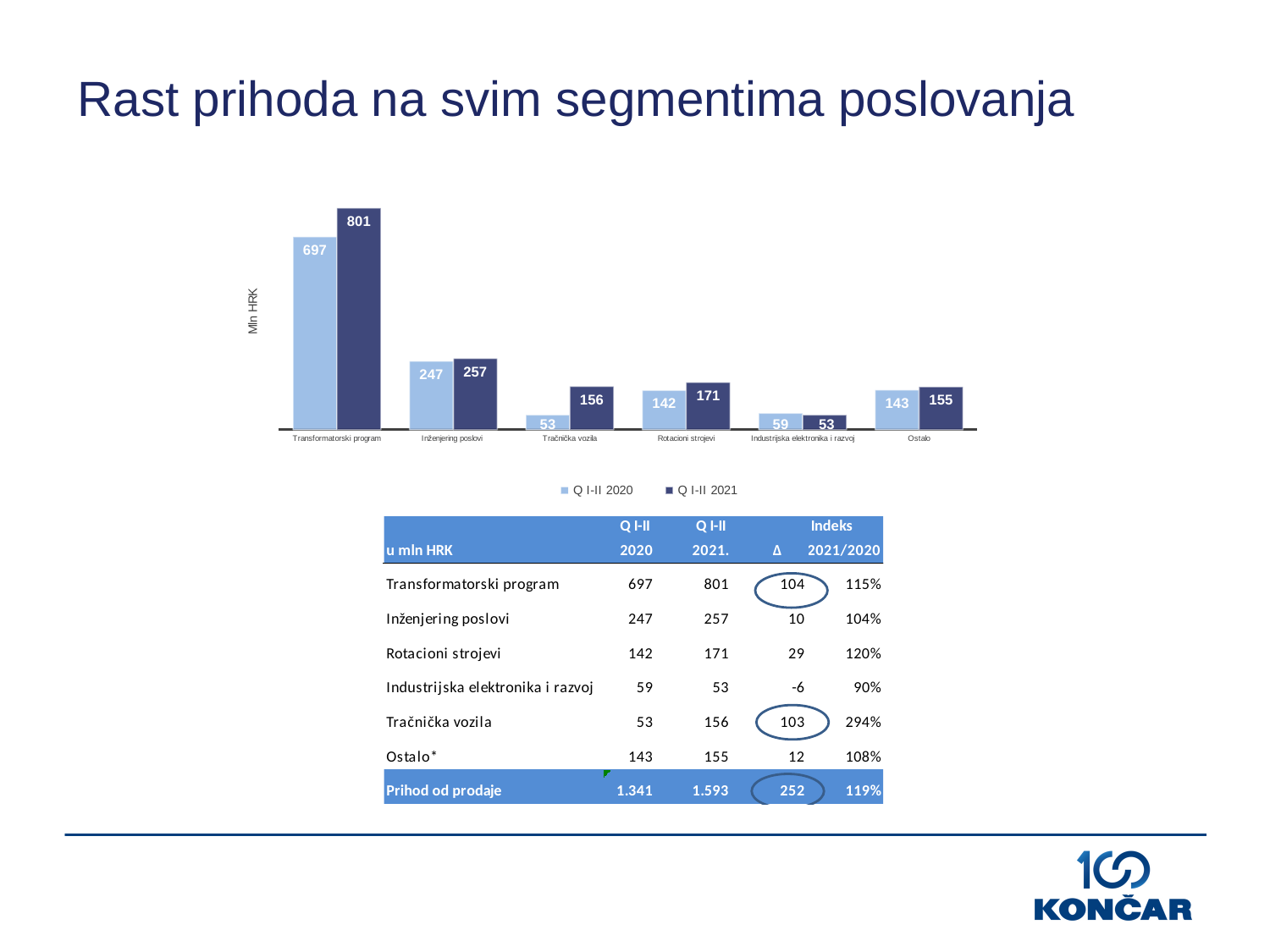
What is the Q I-II 2021 value for Transformatorski program? 801 Which category has the highest Q I-II 2021 value? Transformatorski program What is the Q I-II 2021 value for Rotacioni strojevi? 171 How many series does the chart legend list? 2 What is the difference between the Q I-II 2021 and Q I-II 2020 values for Transformatorski program? 104 What is the Q I-II 2020 value for Tračnička vozila? 53 What unit is shown on the vertical axis label of the chart? Mln HRK Which category has the lowest Q I-II 2021 value? Industrijska elektronika i razvoj For Industrijska elektronika i razvoj, which is larger: the Q I-II 2020 value or the Q I-II 2021 value? Q I-II 2020 What type of chart is shown on the slide? Bar chart What is the difference between the Q I-II 2021 and Q I-II 2020 values for Tračnička vozila? 103 How many categories are shown on the x axis of the chart? 6